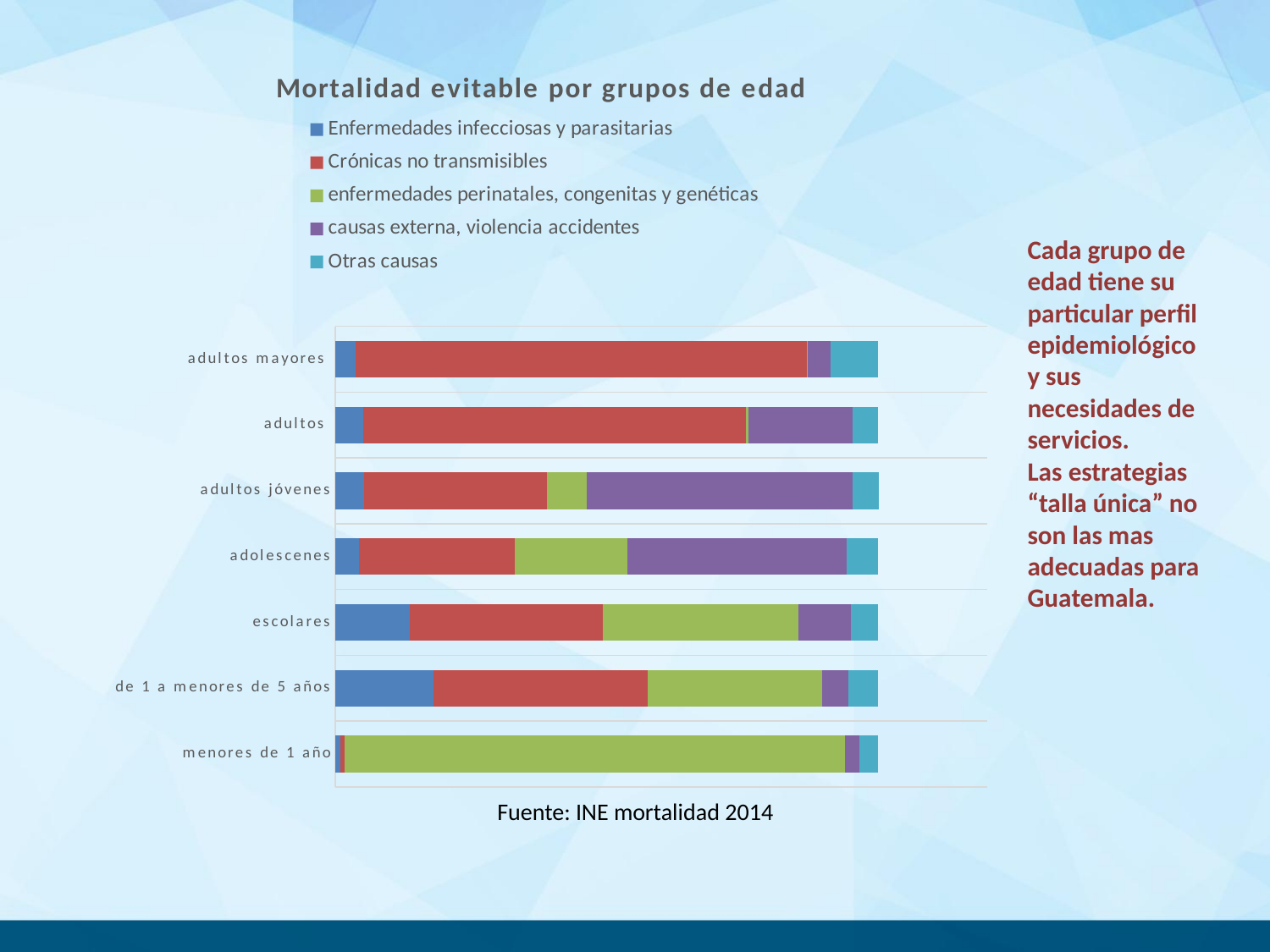
Is the share of 'Enfermedades infecciosas y parasitarias' larger for 'escolares' or for 'adultos mayores'? escolares Which age group has the largest share for 'Crónicas no transmisibles'? adultos mayores Is the share of 'Crónicas no transmisibles' larger for 'adultos' or for 'adolescenes'? adultos Which age group has the largest share for 'enfermedades perinatales, congenitas y genéticas'? menores de 1 año What source is cited below the chart? Fuente: INE mortalidad 2014 What is the title of the chart? Mortalidad evitable por grupos de edad What kind of chart is shown on the slide? Stacked bar chart How many age groups (categories) are plotted in the chart? 7 How many series does the legend list? 5 Which age group has the largest share for 'causas externa, violencia accidentes'? adultos jóvenes Is the share of 'causas externa, violencia accidentes' larger for 'adolescenes' or for 'de 1 a menores de 5 años'? adolescenes Which age group has the smallest share for 'Crónicas no transmisibles'? menores de 1 año